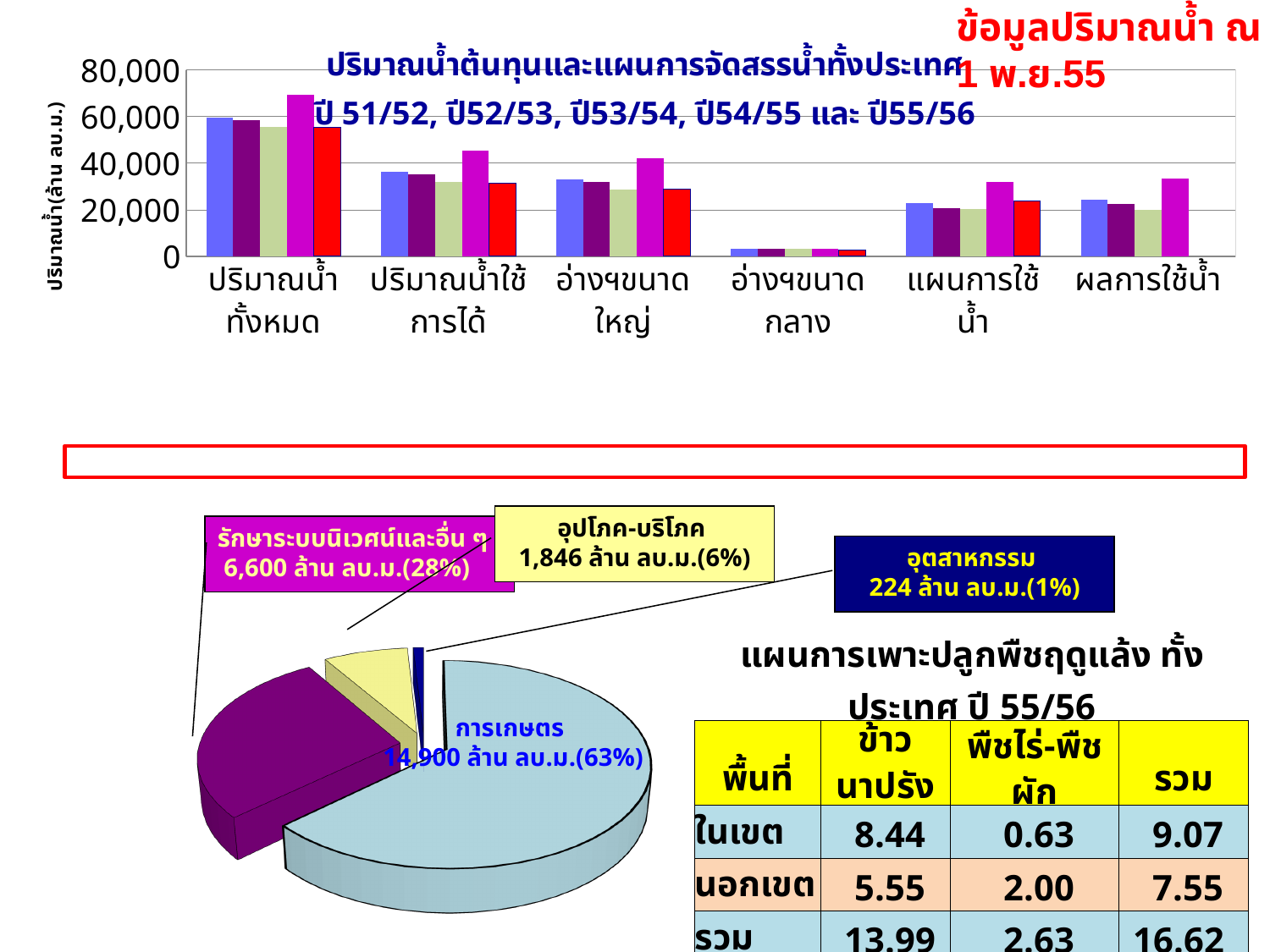
In the pie chart, which slice is the smallest? อุตสาหกรรม What kind of chart is the bottom-left chart on the slide? pie chart In the top bar chart, is the tallest bar for ปริมาณน้ำทั้งหมด greater or less than 60,000? greater In the pie chart, what is the difference between การเกษตร and รักษาระบบนิเวศน์และอื่น ๆ in ล้าน ลบ.ม.? 8,300 In the pie chart, what share does รักษาระบบนิเวศน์และอื่น ๆ have? 28% In the top bar chart, which category has the tallest bars? ปริมาณน้ำทั้งหมด In the top bar chart, are the bars for อ่างฯขนาดกลาง greater or less than 20,000? less In the pie chart, what is the value for การเกษตร? 14,900 ล้าน ลบ.ม. In the top bar chart, how many categories are shown on the x axis? 6 What kind of chart is the top chart on the slide? bar chart In the top bar chart, which category has the shortest bars? อ่างฯขนาดกลาง What is the y-axis label of the top bar chart? ปริมาณน้ำ(ล้าน ลบ.ม.)